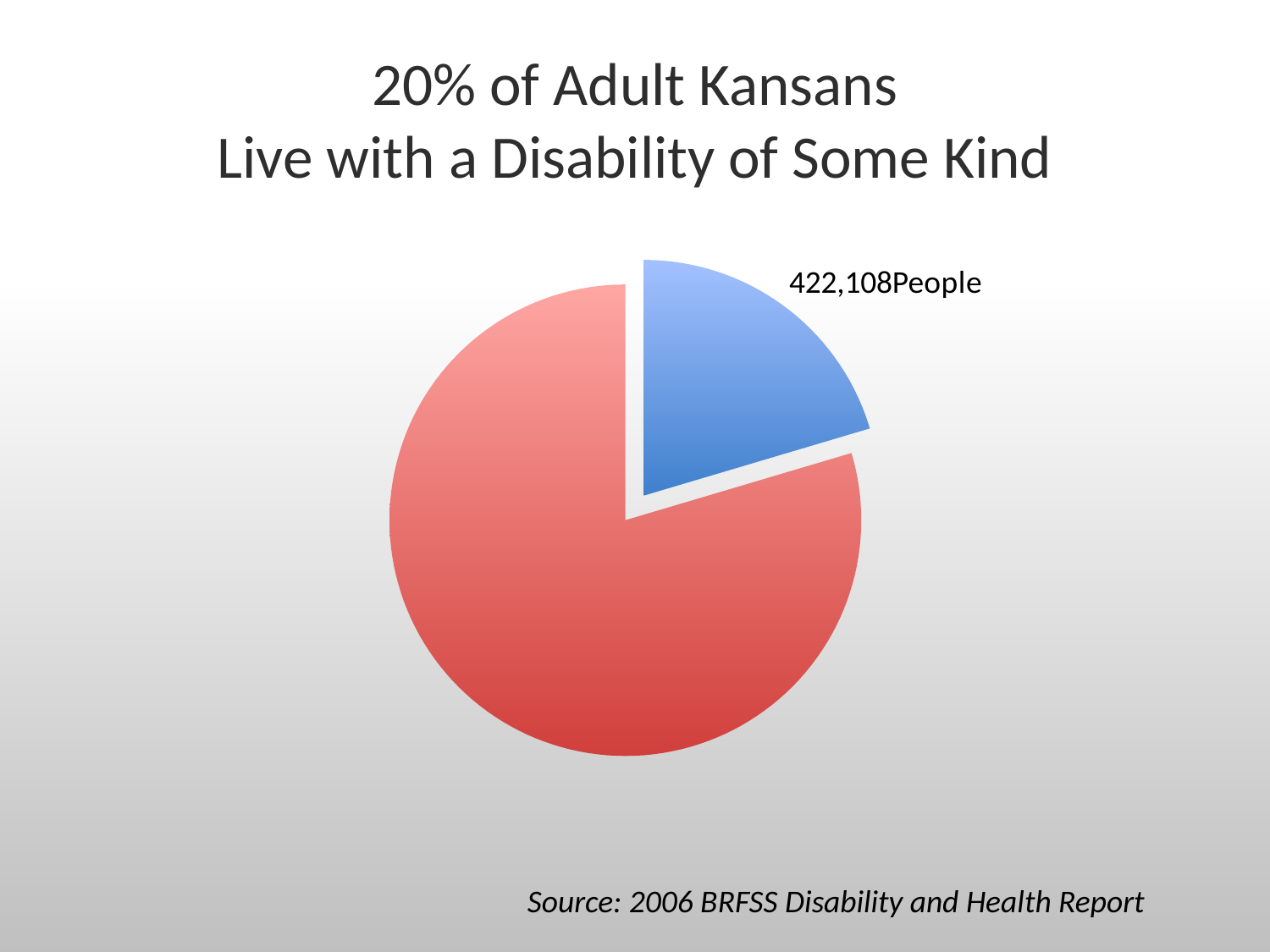
Which slice of the pie chart is the smallest? the blue slice What source is cited for the pie chart data? 2006 BRFSS Disability and Health Report Which slice is larger, the red slice or the blue slice? the red slice According to the slide title, what share of adult Kansans does the blue slice represent? 20% What is the title of the slide containing the pie chart? 20% of Adult Kansans Live with a Disability of Some Kind What data label is printed next to the blue slice of the pie chart? 422,108People How many people does the blue slice of the pie chart represent? 422,108 How many slices does the pie chart have? 2 What kind of chart is shown on the slide? pie chart Which slice of the pie chart is the largest? the red slice